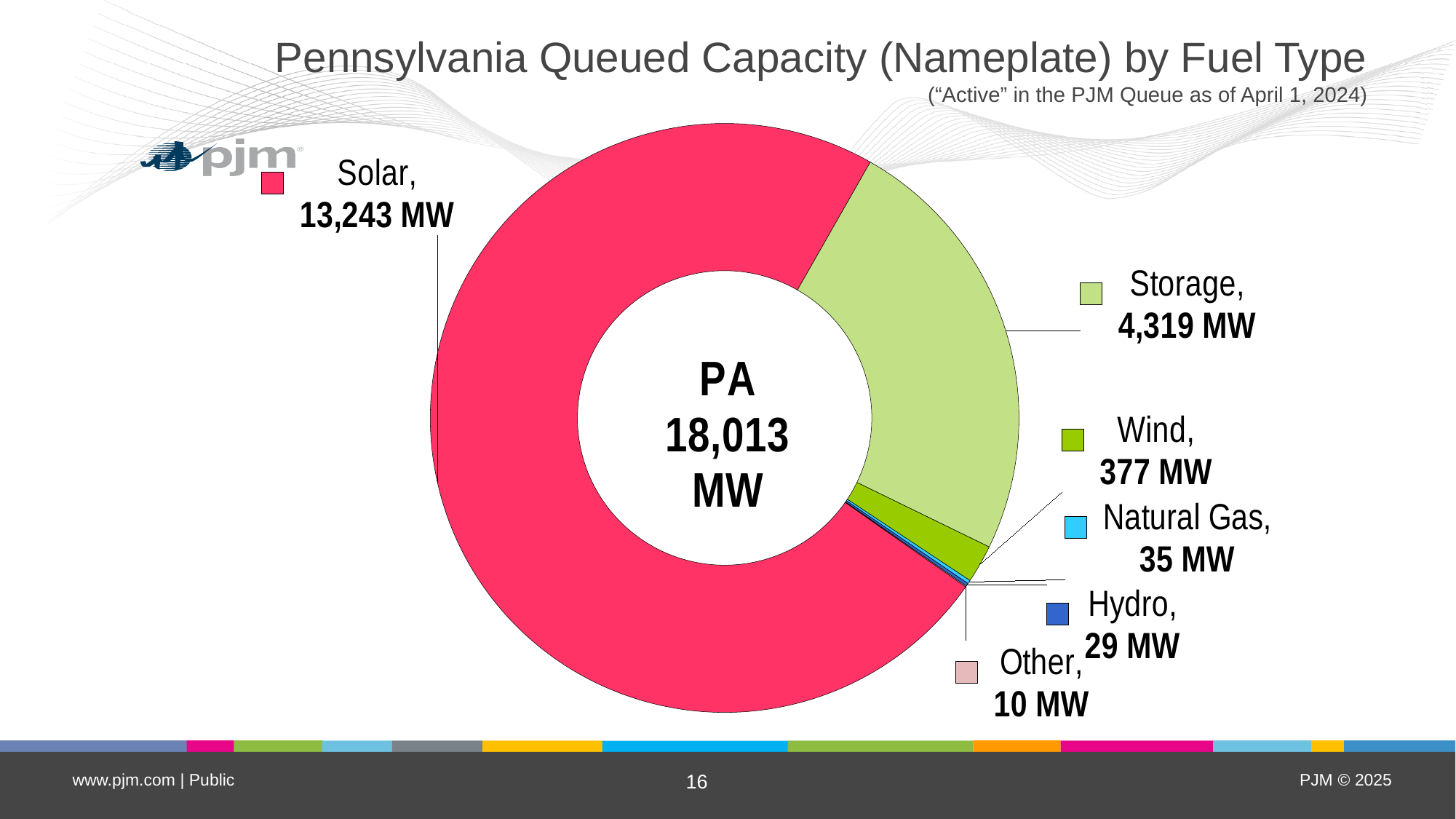
What is the queued capacity for Natural Gas? 35 MW What total queued capacity is shown in the center of the chart? 18,013 MW Which fuel type has the largest queued capacity? Solar Which has more queued capacity, Natural Gas or Hydro? Natural Gas What is the difference in queued capacity between Solar and Storage? 8,924 MW What kind of chart is shown on the slide? Doughnut chart Which fuel type has the smallest queued capacity? Other How many fuel types are shown in the chart? 6 What is the queued capacity for Solar? 13,243 MW What is the queued capacity for Wind? 377 MW What is the queued capacity for Hydro? 29 MW What is the queued capacity for Storage? 4,319 MW